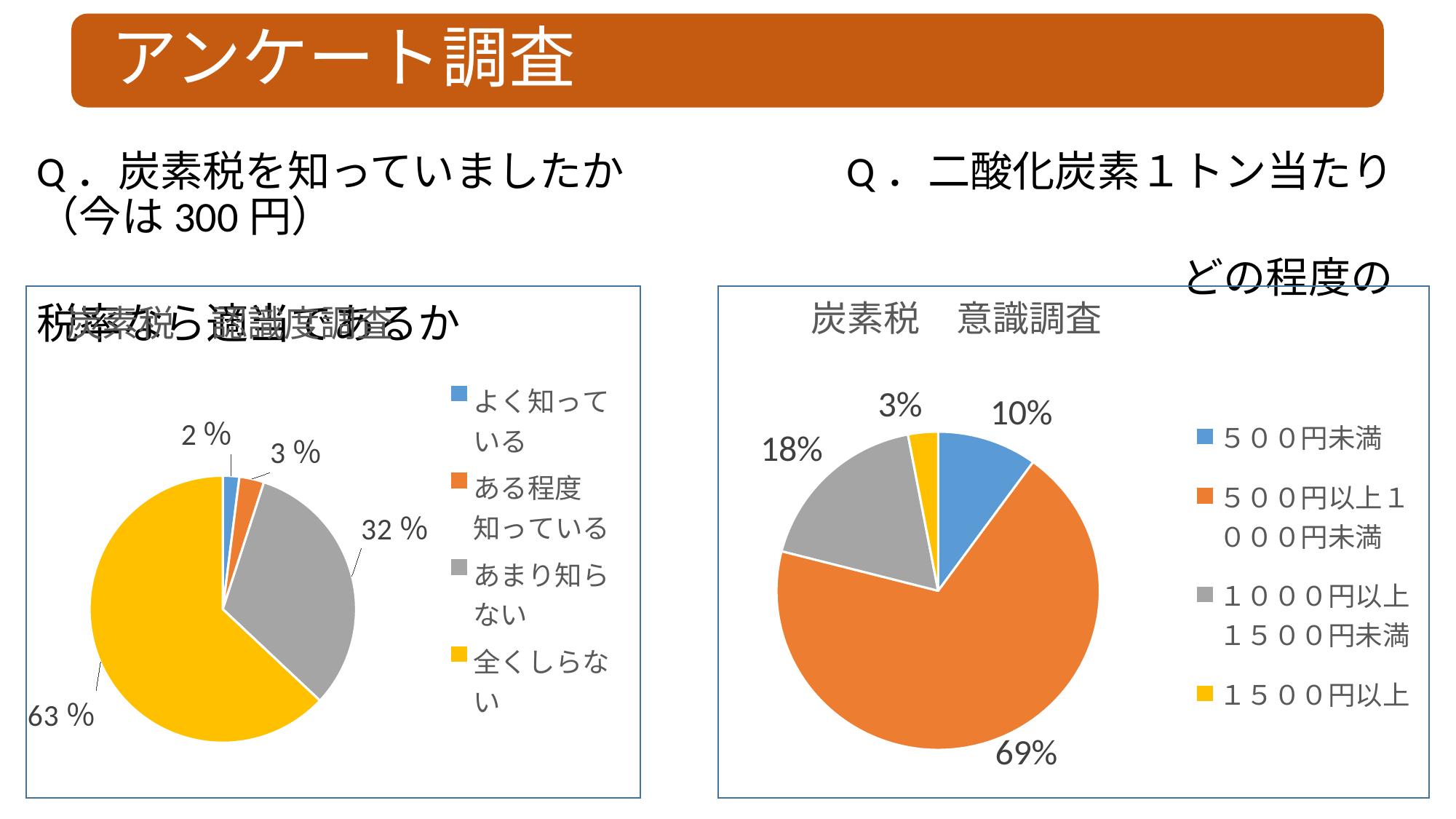
In the left pie chart, what percentage is shown for 全くしらない? 63 % In the left pie chart, what percentage is shown for あまり知らない? 32 % In the chart titled 炭素税 意識調査 on the right, which is larger: the share for ５００円未満 or the share for １０００円以上１５００円未満? １０００円以上１５００円未満 In the chart titled 炭素税 意識調査 on the right, what colour is the slice for ５００円以上１０００円未満? orange In the chart titled 炭素税 意識調査 on the right, what percentage is shown for １０００円以上１５００円未満? 18% In the left pie chart, which category has the smallest share? よく知っている In the chart titled 炭素税 意識調査 on the right, what percentage is shown for ５００円以上１０００円未満? 69% What kind of chart is the chart on the left side of the slide? pie chart In the left pie chart, what is the difference between the shares of 全くしらない and あまり知らない? 31 % In the left pie chart, which category has the largest share? 全くしらない How many categories does the legend of the left pie chart list? 4 In the chart titled 炭素税 意識調査 on the right, which category has the smallest share? １５００円以上